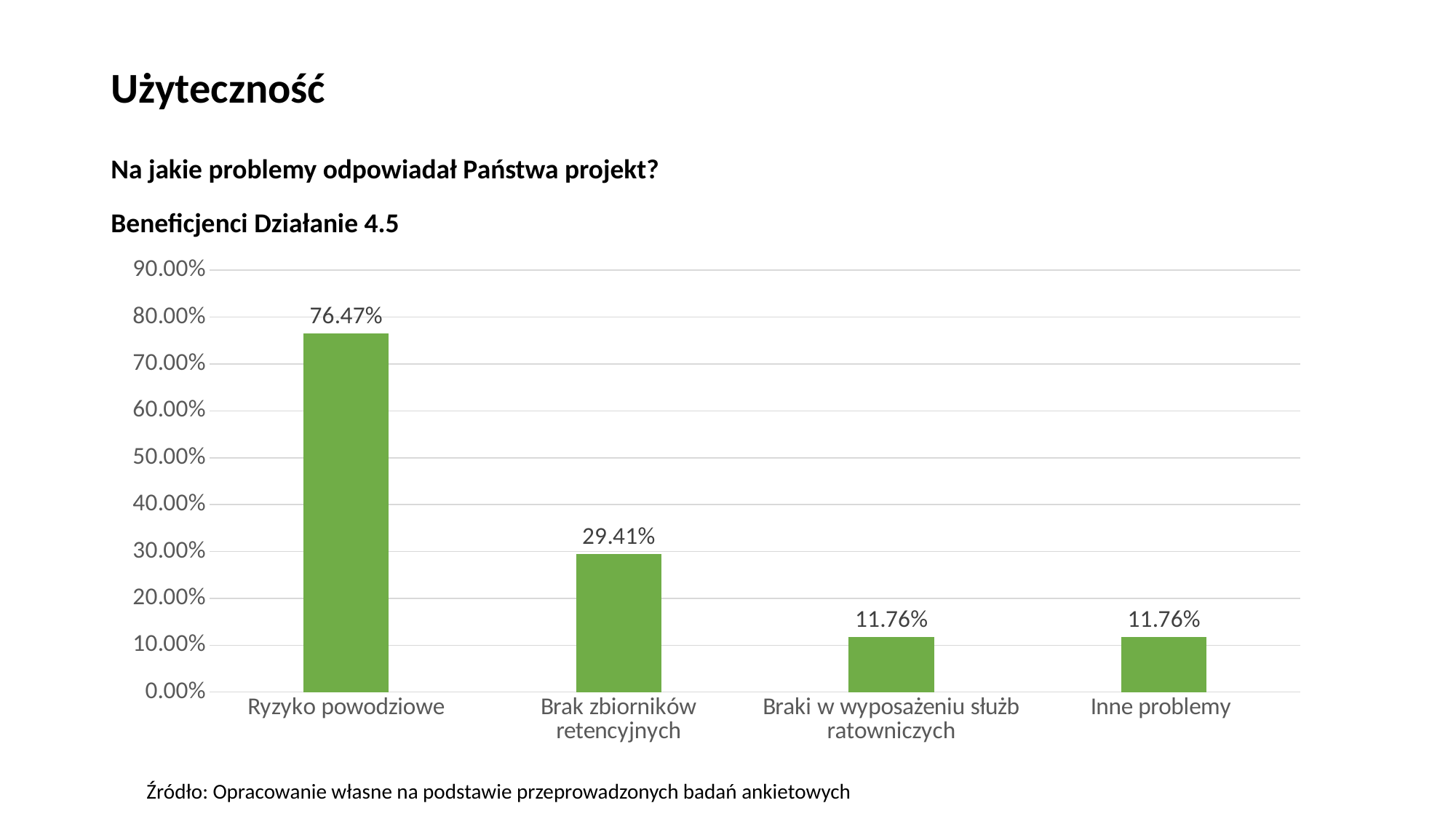
What is the value for Braki w wyposażeniu służb ratowniczych? 11.76% What is the value for Inne problemy? 11.76% How many categories are shown on the chart? 4 What kind of chart is shown on the slide? bar chart What is the value for Brak zbiorników retencyjnych? 29.41% Do the values rise or fall from left to right along the x axis? fall Which is larger, the value for Brak zbiorników retencyjnych or the value for Inne problemy? Brak zbiorników retencyjnych What is the value for Ryzyko powodziowe? 76.47% Is the value for Ryzyko powodziowe greater or less than 70.00%? greater Which category has the highest value? Ryzyko powodziowe What is the difference between the values for Ryzyko powodziowe and Brak zbiorników retencyjnych? 47.06%